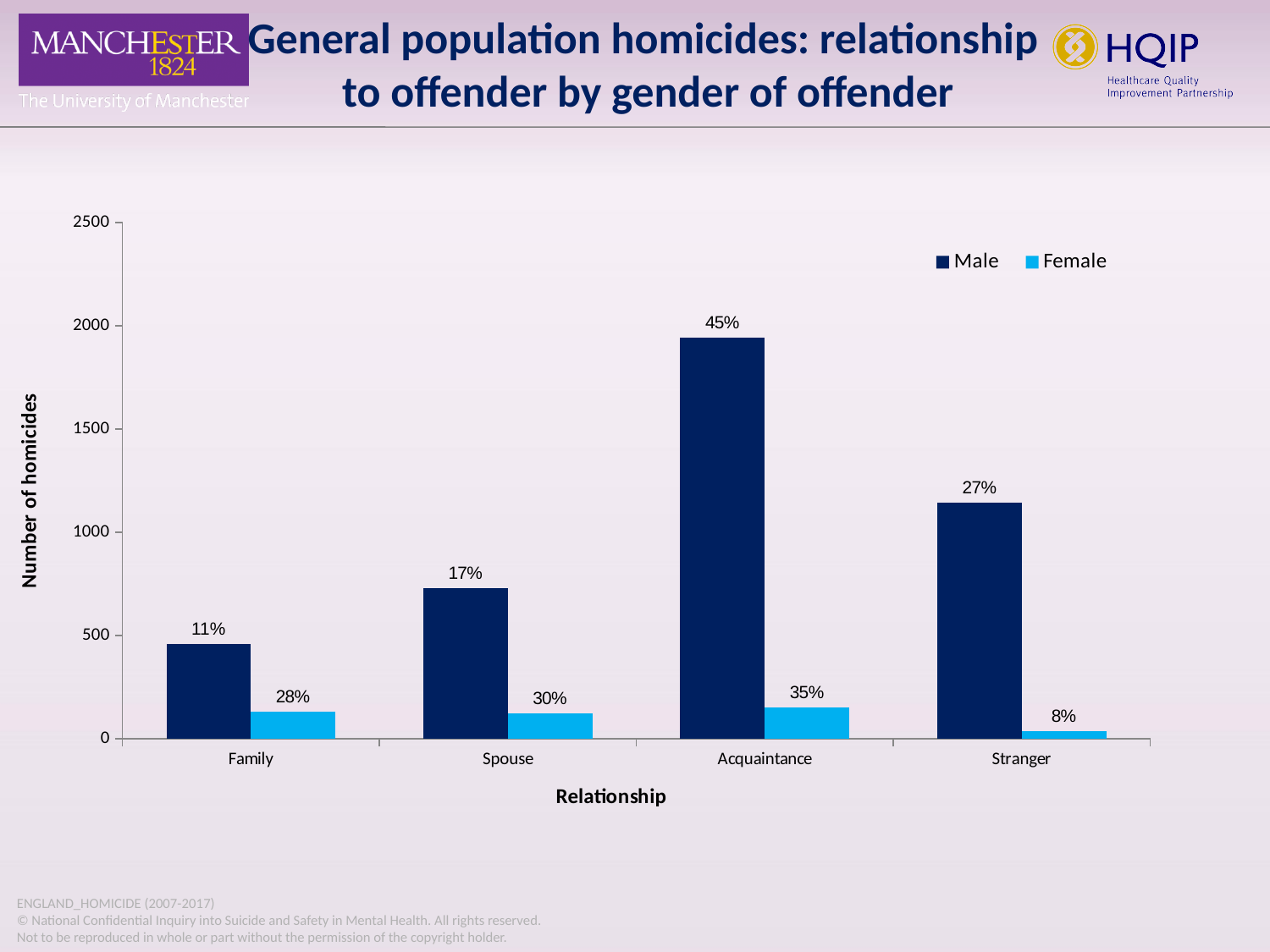
Which is larger: the Male bar for Stranger or the Male bar for Spouse? Male bar for Stranger What percentage label is shown above the Female bar for Spouse? 30% What percentage label is shown above the Male bar for Acquaintance? 45% Is the number of homicides for Male offenders in the Acquaintance category greater or less than 1500? greater How many relationship categories are shown on the x axis? 4 For which relationship category is the Female bar the lowest? Stranger Is the number of homicides for Male offenders in the Family category greater or less than 500? less What type of chart is shown on the slide? bar chart How many series does the legend list? 2 What percentage label is shown above the Male bar for Family? 11% What percentage label is shown above the Female bar for Stranger? 8% For which relationship category is the Male bar the highest? Acquaintance